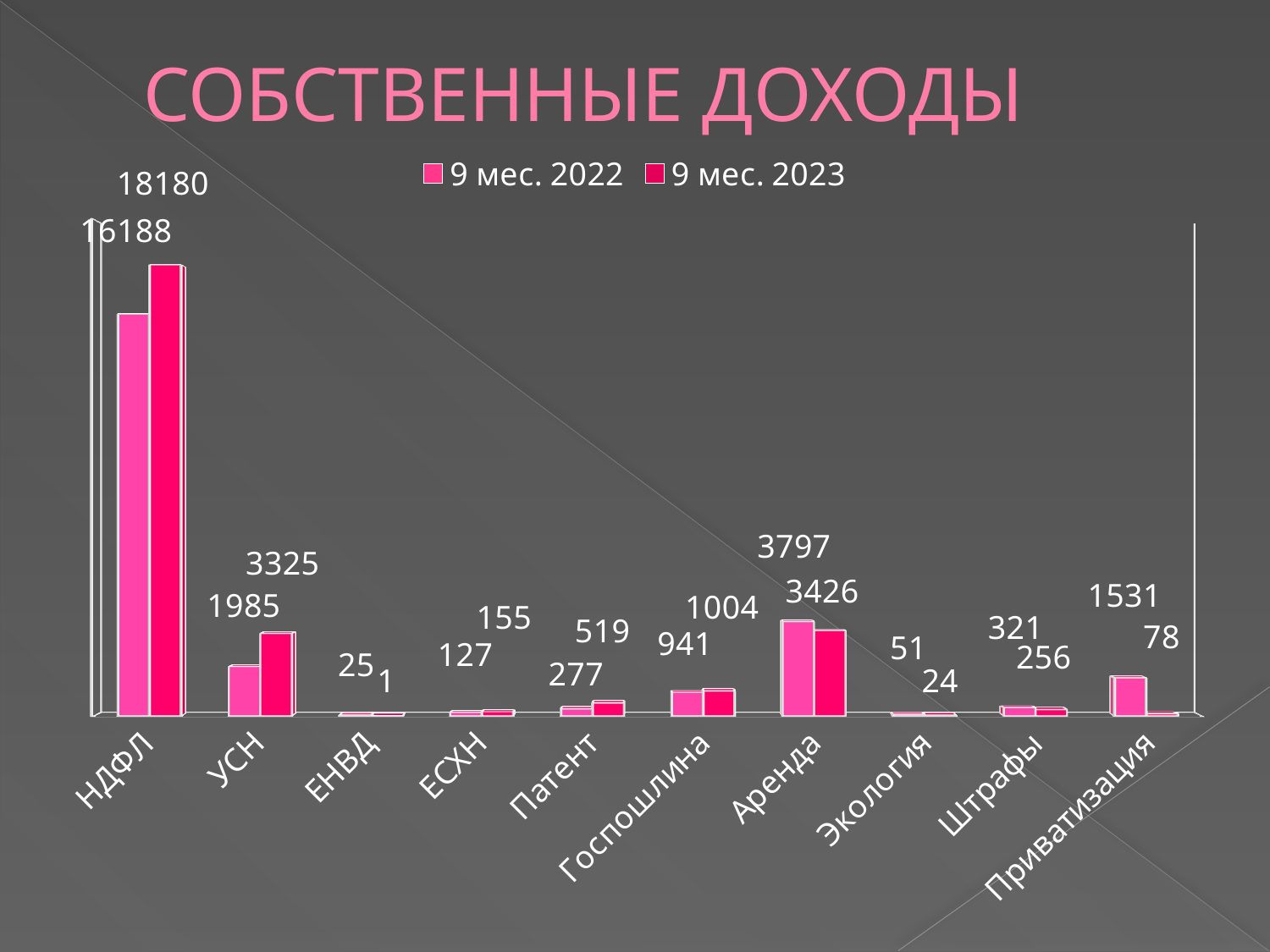
Which category has the lowest value in the 9 мес. 2023 series? ЕНВД What kind of chart is shown on the slide? Bar chart What is the difference between the 9 мес. 2022 and 9 мес. 2023 values for Приватизация? 1453 What is the difference between the 9 мес. 2023 and 9 мес. 2022 values for УСН? 1340 How many series does the legend list? 2 Which category has the highest value in the 9 мес. 2023 series? НДФЛ Which is larger for Штрафы: the 9 мес. 2022 value or the 9 мес. 2023 value? 9 мес. 2022 What is the value for Аренда in the 9 мес. 2022 series? 3797 What is the value for НДФЛ in the 9 мес. 2023 series? 18180 What is the value for Приватизация in the 9 мес. 2023 series? 78 What is the title of the chart? СОБСТВЕННЫЕ ДОХОДЫ How many categories are shown on the x axis? 10